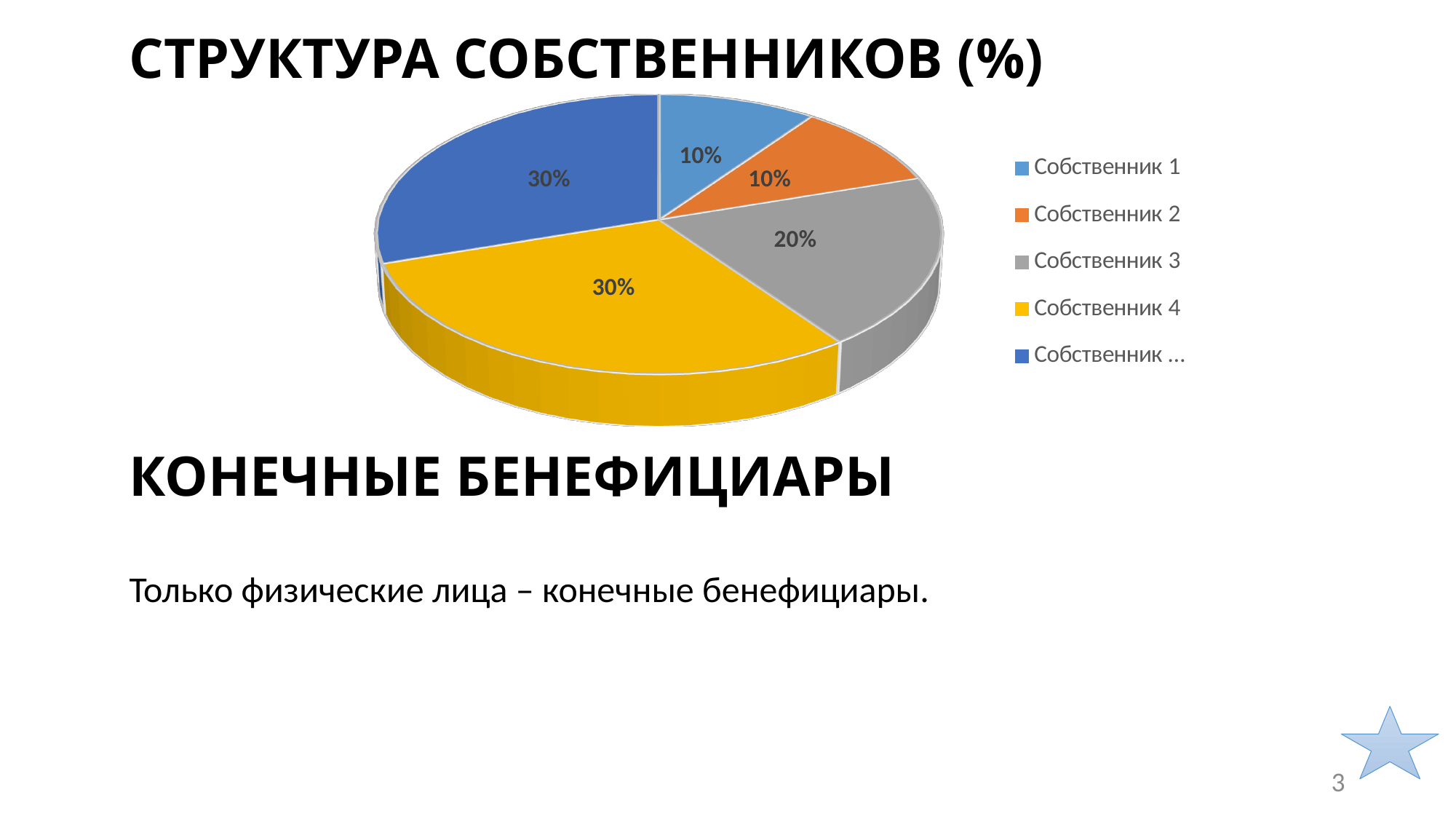
What share of the pie does Собственник 2 hold? 10% How many slices does the pie chart have? 5 Which is larger, the slice for Собственник 1 or the slice for Собственник 3? Собственник 3 What share of the pie does Собственник 4 hold? 30% Which is larger, the slice for Собственник 3 or the slice for Собственник 4? Собственник 4 What kind of chart is shown on the slide? Pie chart What share of the pie does Собственник 3 hold? 20% What share of the pie does Собственник 1 hold? 10% What is the title of the chart? СТРУКТУРА СОБСТВЕННИКОВ (%) What colour is the slice for Собственник 4? Yellow What is the difference between the shares of Собственник 4 and Собственник 2? 20% What share of the pie does Собственник ... hold? 30%